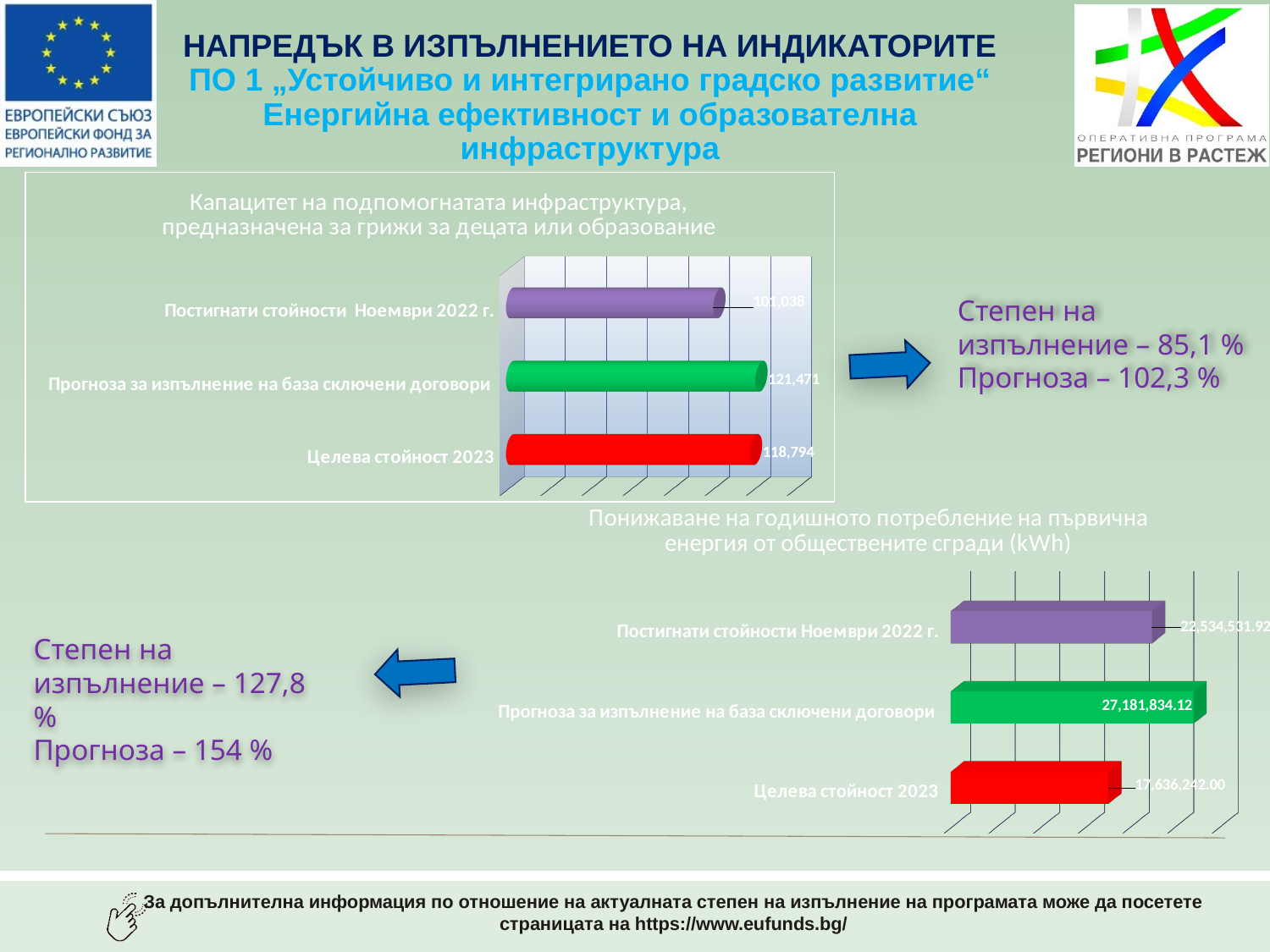
In the top chart (Капацитет на подпомогнатата инфраструктура), which category has the highest value? Прогноза за изпълнение на база сключени договори In the bottom chart (Понижаване на годишното потребление на първична енергия), what is the value for Целева стойност 2023? 17,636,242.00 In the top chart (Капацитет на подпомогнатата инфраструктура), how many bars are plotted? 3 In the top chart (Капацитет на подпомогнатата инфраструктура), what is the value for Целева стойност 2023? 118,794 In the top chart (Капацитет на подпомогнатата инфраструктура), what is the difference between Прогноза за изпълнение на база сключени договори and Целева стойност 2023? 2,677 In the bottom chart (Понижаване на годишното потребление на първична енергия), which is larger: Постигнати стойности Ноември 2022 г. or Прогноза за изпълнение на база сключени договори? Прогноза за изпълнение на база сключени договори In the bottom chart (Понижаване на годишното потребление на първична енергия), what is the difference between Прогноза за изпълнение на база сключени договори and Постигнати стойности Ноември 2022 г.? 4,647,302.20 In the top chart (Капацитет на подпомогнатата инфраструктура), what is the value for Прогноза за изпълнение на база сключени договори? 121,471 In the bottom chart (Понижаване на годишното потребление на първична енергия), which category has the lowest value? Целева стойност 2023 What type of chart is the bottom chart (Понижаване на годишното потребление на първична енергия)? Bar chart In the top chart (Капацитет на подпомогнатата инфраструктура), which category has the lowest value? Постигнати стойности Ноември 2022 г. In the bottom chart (Понижаване на годишното потребление на първична енергия), what is the value for Прогноза за изпълнение на база сключени договори? 27,181,834.12